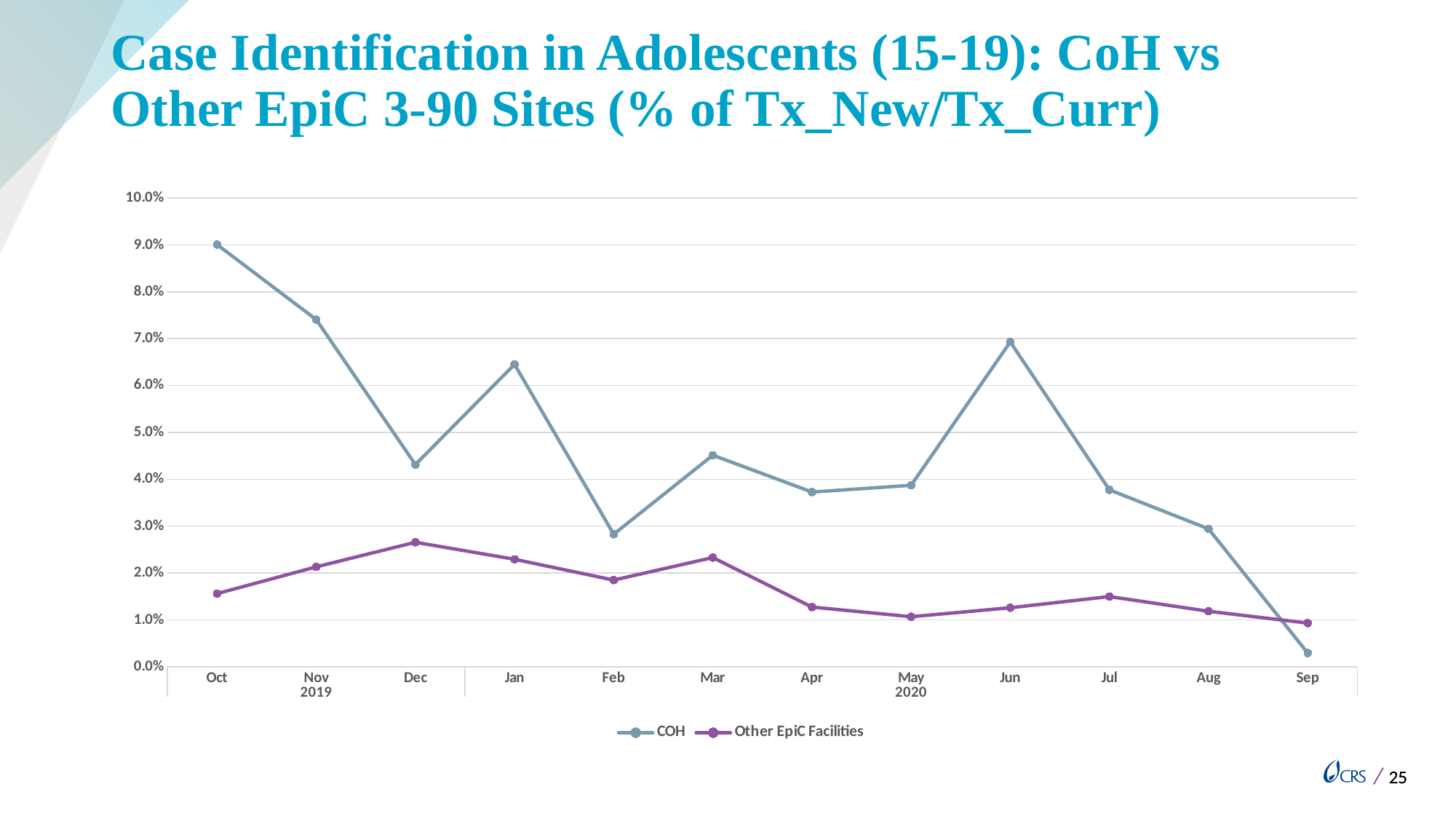
How many series does the legend list? 2 Overall, does the COH series rise or fall from Oct to Sep? Fall Is the Other EpiC Facilities value for Dec greater or less than 2.0%? greater In Sep, which series has the higher value, COH or Other EpiC Facilities? Other EpiC Facilities In which month is the COH series at its highest? Oct What kind of chart is shown on the slide? Line chart For the COH series, which month has the larger value, Jun or Jul? Jun Is the COH value for Nov greater or less than 7.0%? greater Is the COH value for Feb greater or less than 3.0%? less In which month is the Other EpiC Facilities series at its highest? Dec How many months are plotted along the x axis? 12 In which month is the COH series at its lowest? Sep